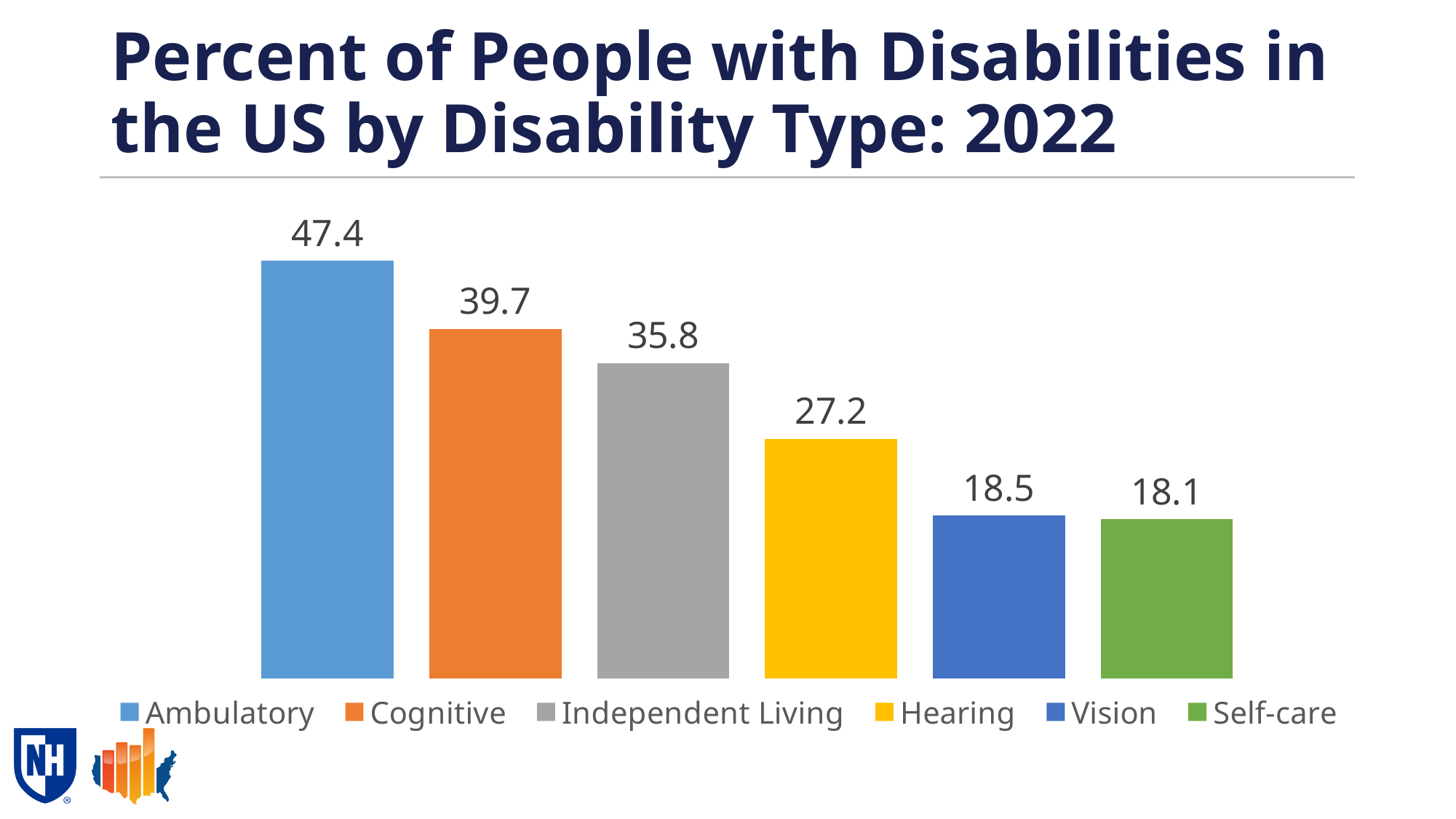
Which disability type has the lowest value? Self-care What is the difference between the values for Independent Living and Hearing? 8.6 What is the value for Hearing? 27.2 What is the value for Ambulatory? 47.4 What kind of chart is shown on the slide? Bar chart Which is larger, the value for Cognitive or the value for Independent Living? Cognitive How many disability types are shown in the chart? 6 What is the difference between the values for Ambulatory and Cognitive? 7.7 Which disability type has the highest value? Ambulatory What colour is the bar for Hearing? Yellow How many entries does the legend list? 6 What is the value for Self-care? 18.1